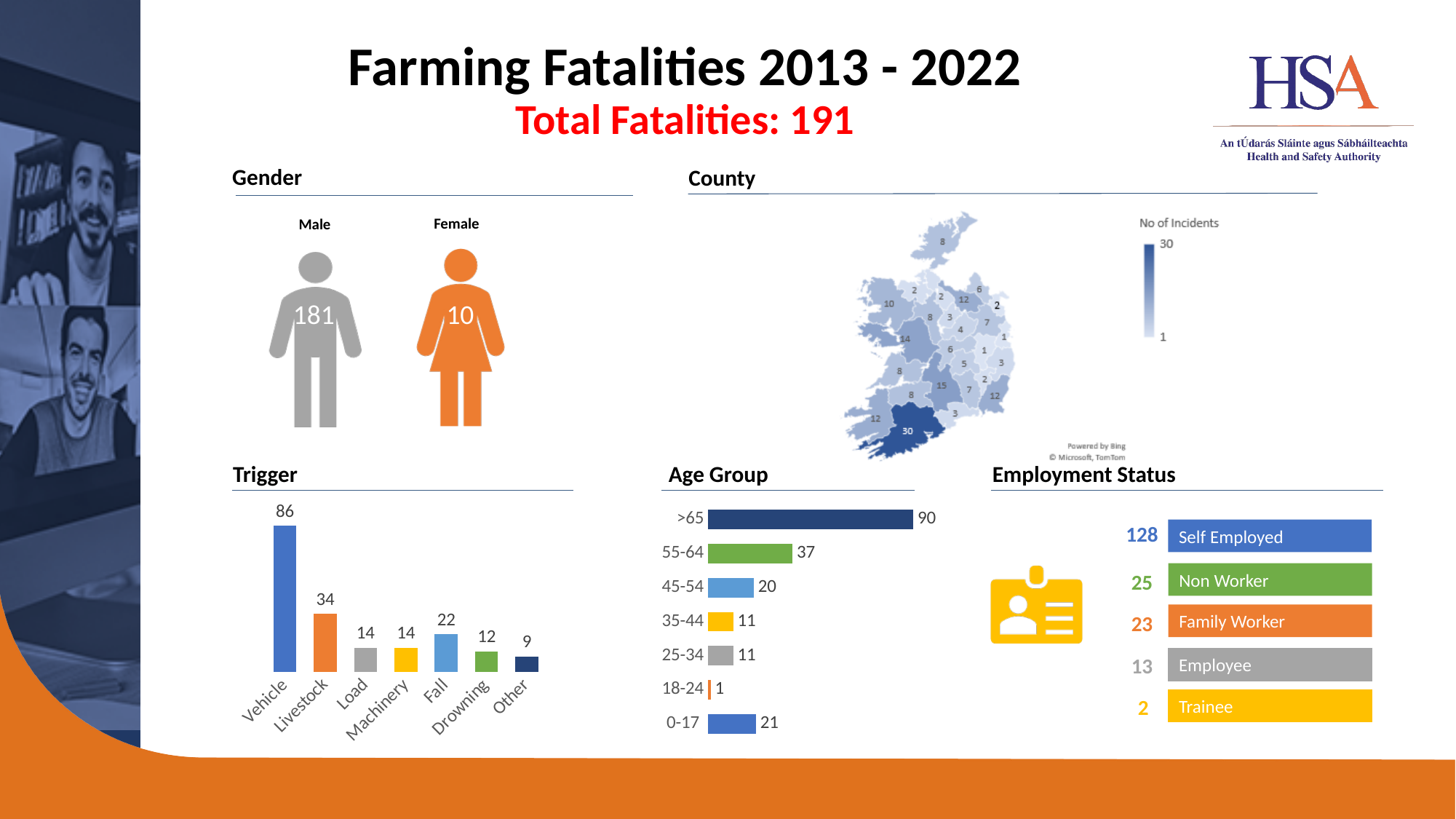
In the Age Group chart, which age group has the highest value? >65 In the Age Group chart, what is the value for 55-64? 37 In the Age Group chart, which age group has the lowest value? 18-24 What kind of chart is the Age Group chart? Bar chart In the County map, what is the maximum value shown on the 'No of Incidents' legend scale? 30 In the Trigger chart, how many trigger categories are shown? 7 In the Age Group chart, what is the difference between >65 and 0-17? 69 In the Trigger chart, which is larger, Drowning or Fall? Fall In the Trigger chart, which trigger has the lowest value? Other In the Trigger chart, what is the value for Vehicle? 86 In the Age Group chart, how many age groups are shown? 7 In the Trigger chart, what is the difference between Livestock and Fall? 12